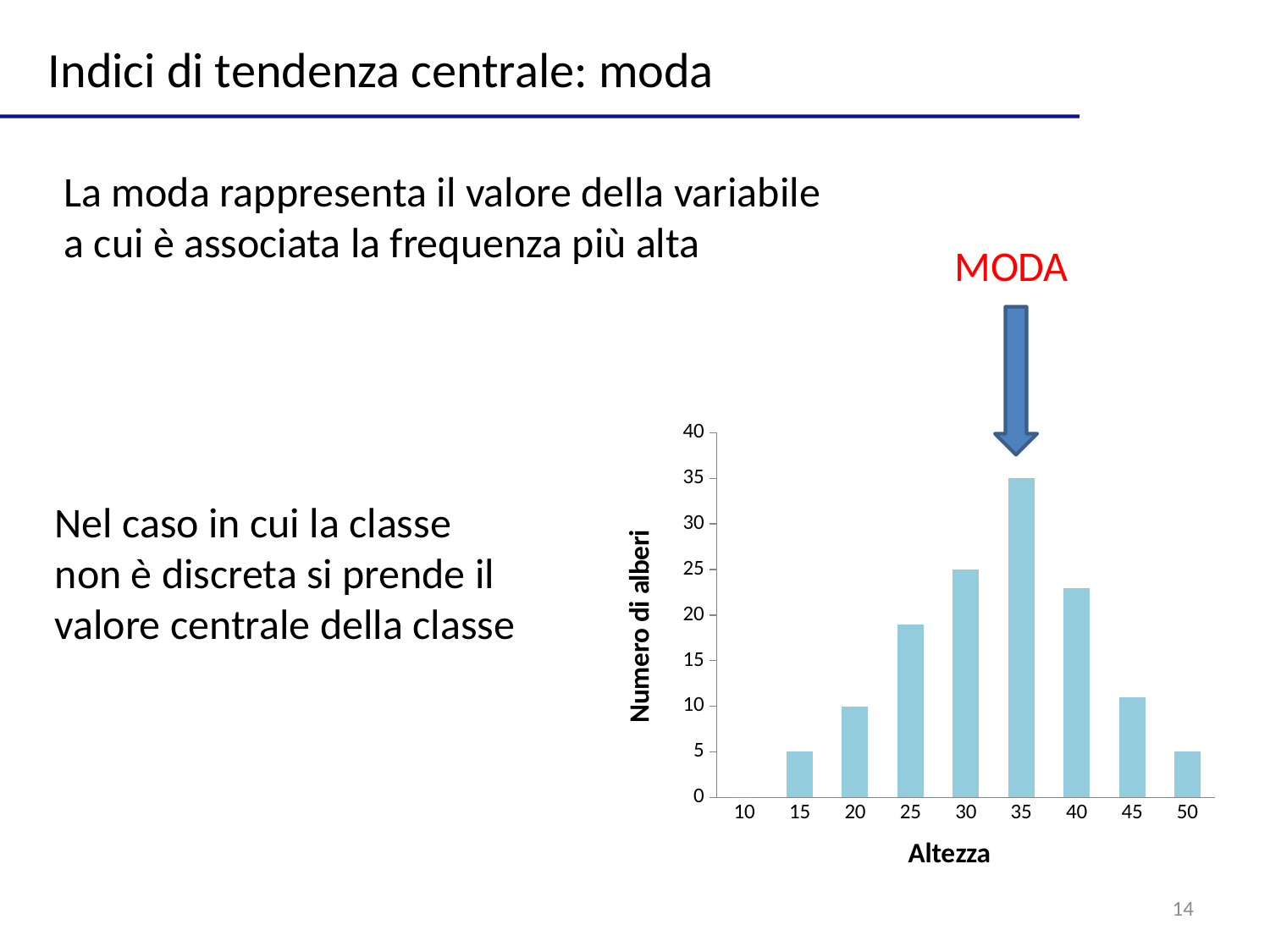
What kind of chart is shown on the slide? bar chart Is the value for Altezza 25 greater or less than 15? greater How do the values change as Altezza increases from 10 to 50? They rise up to 35, then fall Which Altezza category has the highest number of trees (Numero di alberi)? 35 What is the value of Numero di alberi for Altezza 15? 5 Is the value for Altezza 45 greater or less than 15? less What is the value of Numero di alberi for Altezza 35? 35 What is the title of the y axis? Numero di alberi What is the difference between the values for Altezza 35 and Altezza 30? 10 What is the value of Numero di alberi for Altezza 30? 25 Which is larger, the value for Altezza 30 or the value for Altezza 40? Altezza 30 How many Altezza categories are shown on the x axis? 9